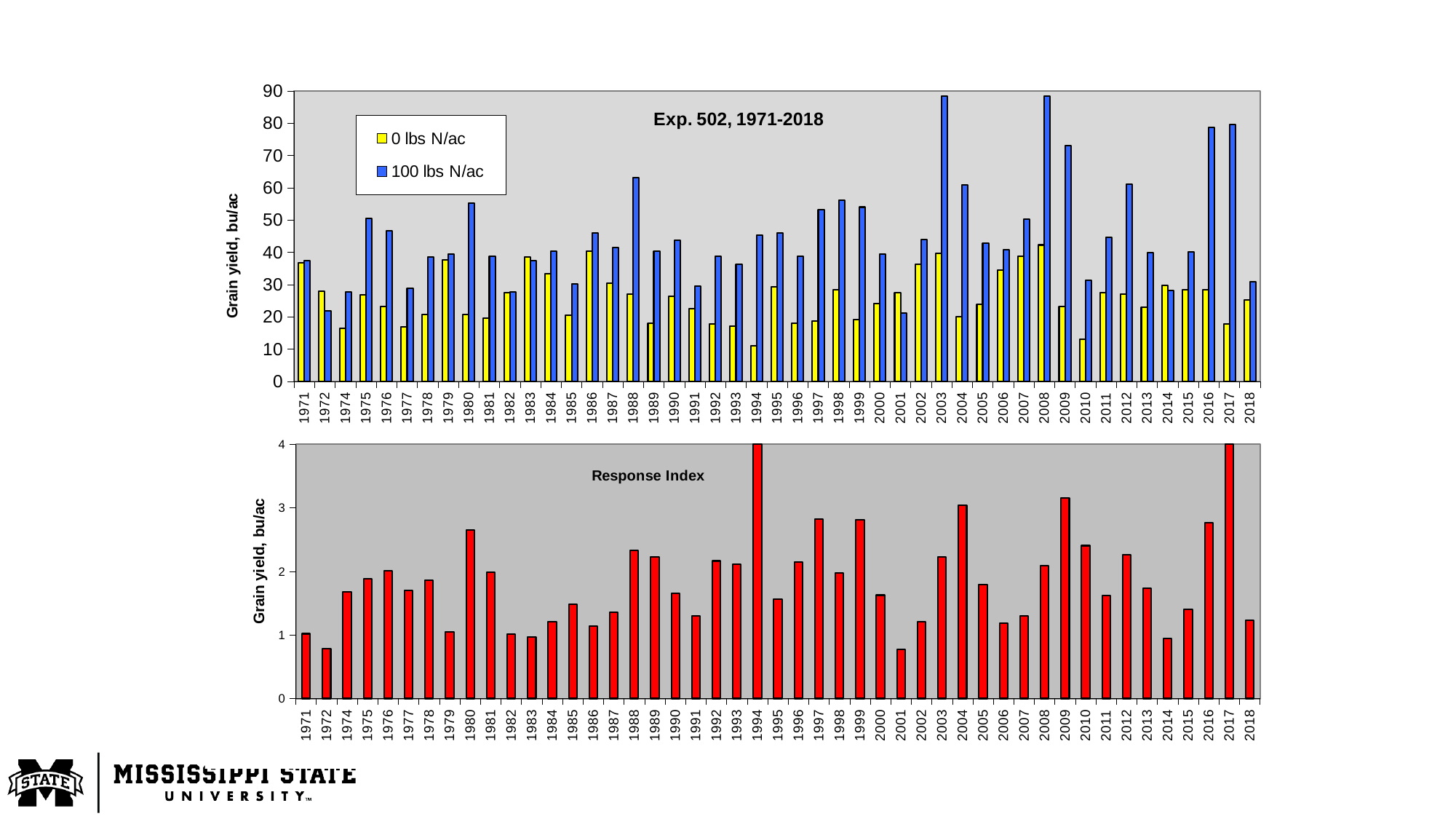
In the top chart 'Exp. 502, 1971-2018', is the 100 lbs N/ac value for 1988 greater or less than 60? greater In the bottom chart 'Response Index', which is larger: the value for 1997 or for 1998? 1997 In the top chart 'Exp. 502, 1971-2018', is the 0 lbs N/ac value for 2010 greater or less than 20? less What is the title of the bottom chart? Response Index In the top chart 'Exp. 502, 1971-2018', what are the two legend entries? 0 lbs N/ac and 100 lbs N/ac How many series does the legend of the top chart 'Exp. 502, 1971-2018' list? 2 What kind of chart is the top chart titled 'Exp. 502, 1971-2018'? bar chart In the top chart 'Exp. 502, 1971-2018', which is larger: the 100 lbs N/ac value for 1979 or for 1980? 1980 In the bottom chart 'Response Index', is the value for 2009 greater or less than 3? greater In the top chart 'Exp. 502, 1971-2018', which year has the lowest 0 lbs N/ac value? 1994